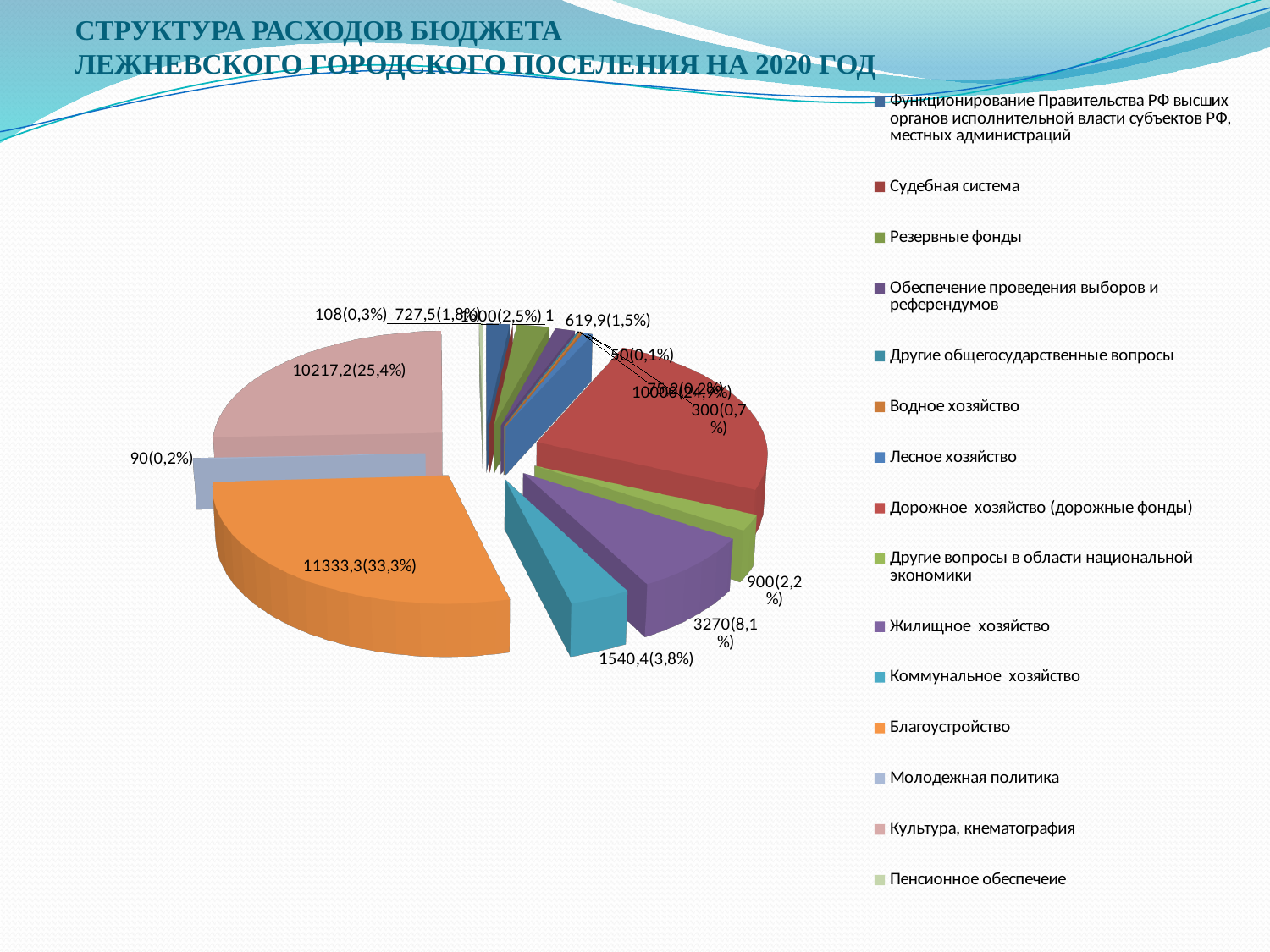
What share of the pie does Благоустройство take? 33,3% How many categories does the legend list? 15 What value is shown for Благоустройство? 11333,3(33,3%) What is the difference between the values for Благоустройство and Культура, кнематография? 1116,1 What value is shown for Культура, кнематография? 10217,2(25,4%) What kind of chart is shown on the slide? pie chart What value is shown for Дорожное хозяйство (дорожные фонды)? 10000(24,9%) What value is shown for Коммунальное хозяйство? 1540,4(3,8%) What share of the pie does Жилищное хозяйство take? 8,1% Which is larger, the slice for Благоустройство or the slice for Культура, кнематография? Благоустройство Which category has the largest slice of the pie? Благоустройство What value is shown for Жилищное хозяйство? 3270(8,1%)